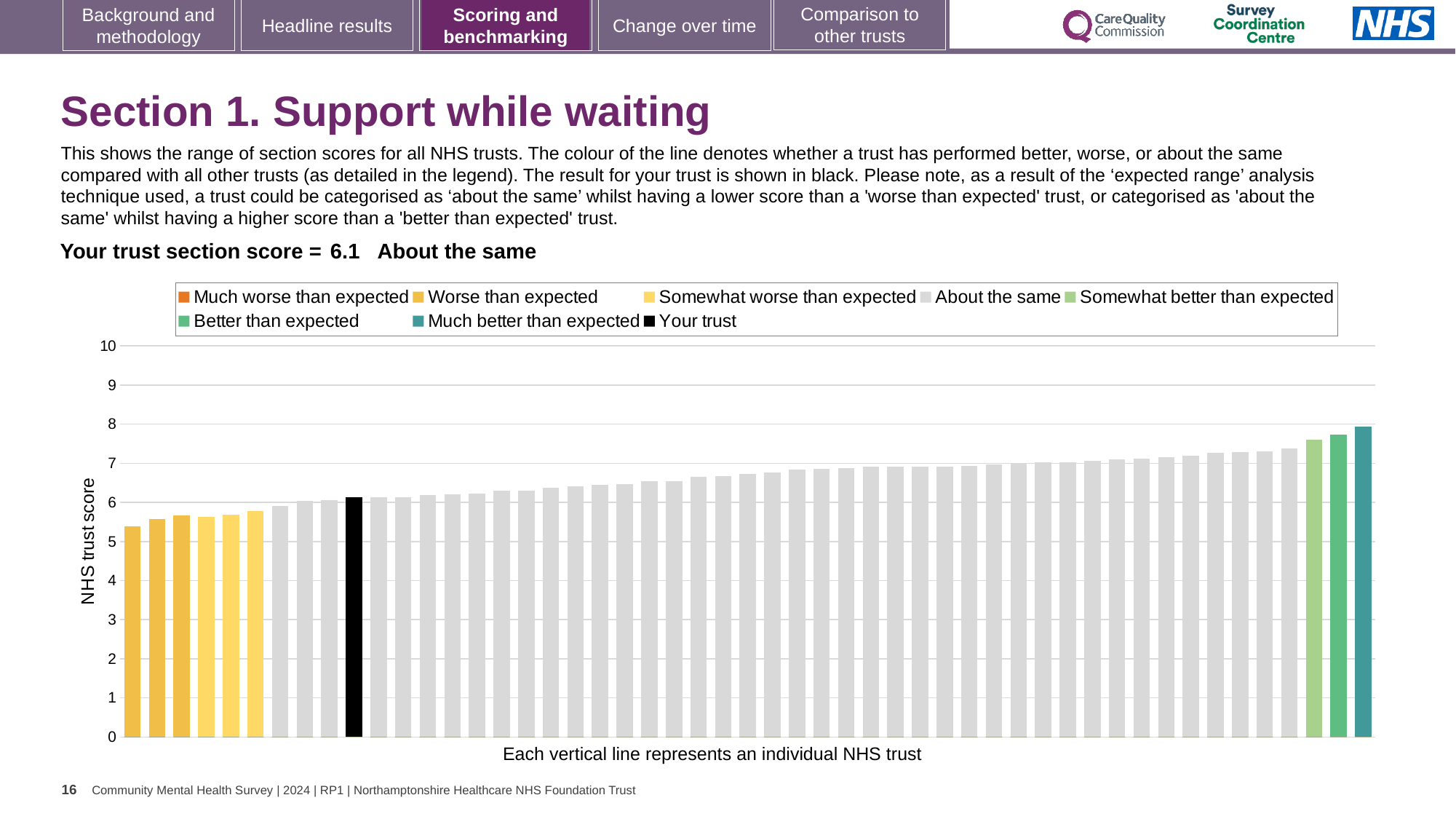
Is the value of the black 'Your trust' bar greater or less than 7? less What is the label on the y axis? NHS trust score Is the value of the shortest bar greater or less than 5? greater Do the bar values rise or fall from left to right along the x axis? rise What kind of chart is shown on the slide? bar chart Which legend category does the tallest bar belong to? Much better than expected Which legend category does the shortest bar belong to? Worse than expected Is the value of the tallest bar greater or less than 7? greater How many entries does the chart legend list? 8 What is the section score for your trust? 6.1 Which is taller, the black 'Your trust' bar or the rightmost bar? the rightmost bar